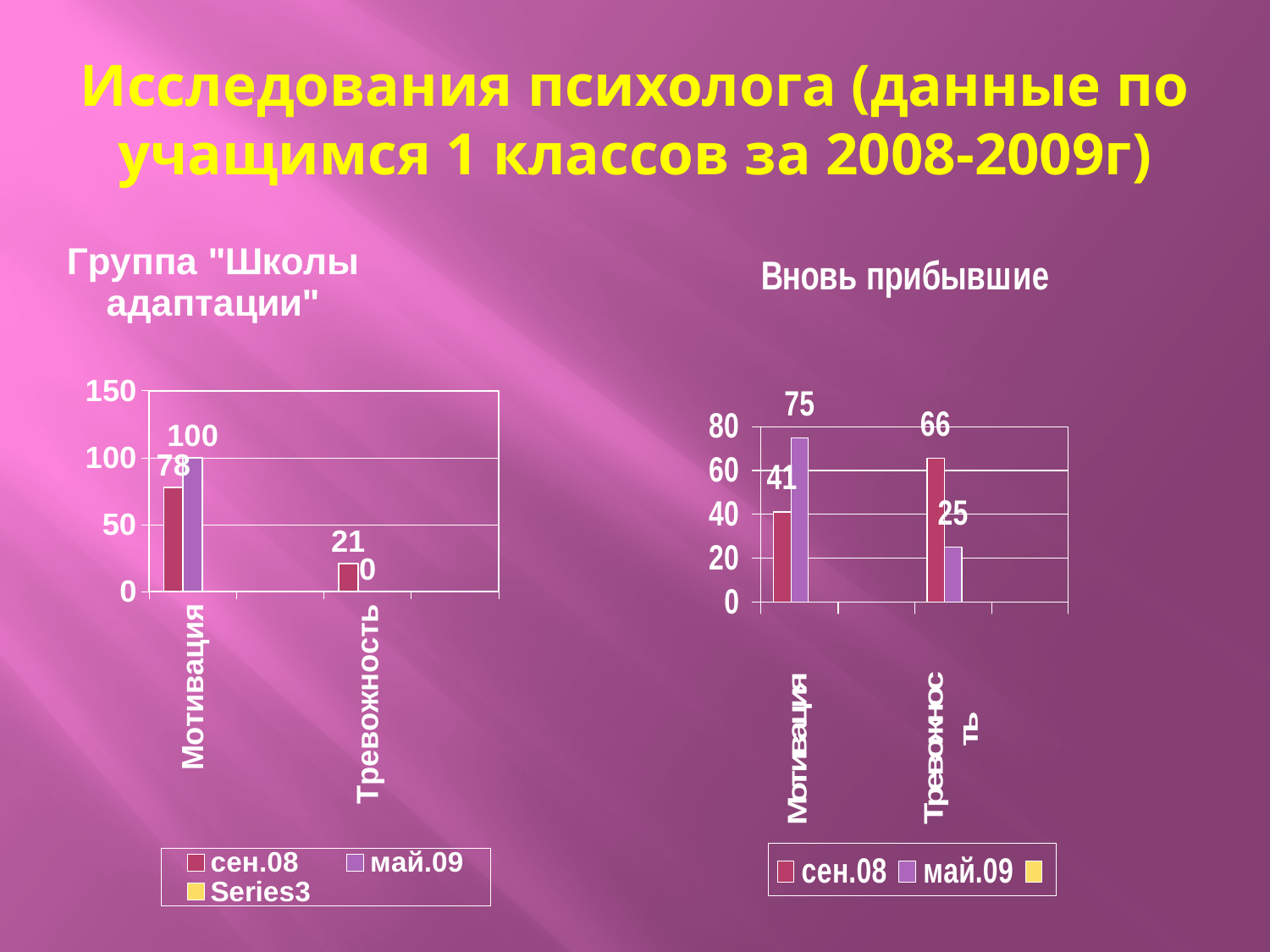
In the chart "Группа "Школы адаптации"", what is the value for Мотивация in май.09? 100 In the chart "Группа "Школы адаптации"", what is the value for Тревожность in сен.08? 21 In the chart "Вновь прибывшие", which is larger for Тревожность: сен.08 or май.09? сен.08 In the chart "Группа "Школы адаптации"", what is the value for Тревожность in май.09? 0 In the chart "Вновь прибывшие", what is the value for Тревожность in май.09? 25 In the chart "Группа "Школы адаптации"", how many series does the legend list? 3 In the chart "Группа "Школы адаптации"", what is the value for Мотивация in сен.08? 78 In the chart "Вновь прибывшие", what is the value for Мотивация in сен.08? 41 What kind of chart is "Вновь прибывшие"? Bar chart In the chart "Группа "Школы адаптации"", what is the difference between the май.09 and сен.08 values for Мотивация? 22 In the chart "Вновь прибывшие", which category has the highest май.09 value? Мотивация In the chart "Вновь прибывшие", what is the difference between the сен.08 and май.09 values for Тревожность? 41